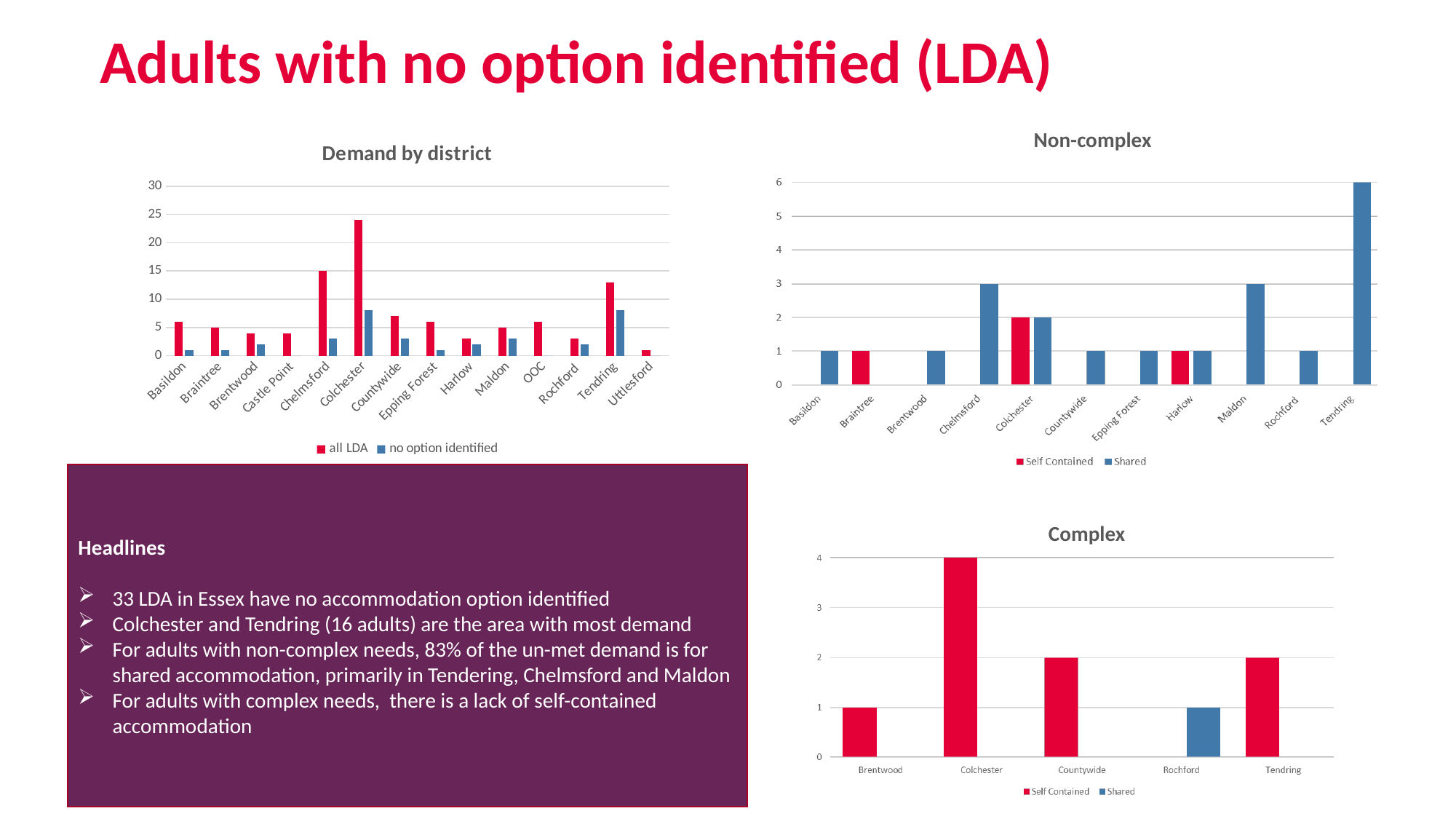
In the Non-complex chart, what is the Shared value for Tendring? 6 How many categories are shown on the x axis of the Complex chart? 5 In the Demand by district chart, which district has the highest all LDA value? Colchester How many categories are shown on the x axis of the Non-complex chart? 11 What kind of chart is the Demand by district chart? bar chart In the Complex chart, what is the Self Contained value for Colchester? 4 In the Non-complex chart, which district has the highest Shared value? Tendring In the Complex chart, what is the difference between the Self Contained values for Colchester and Countywide? 2 In the Demand by district chart, is the all LDA value for Colchester greater or less than 20? greater In the Complex chart, which category has the highest Self Contained value? Colchester In the Non-complex chart, what is the Shared value for Chelmsford? 3 How many series does the legend of the Demand by district chart list? 2